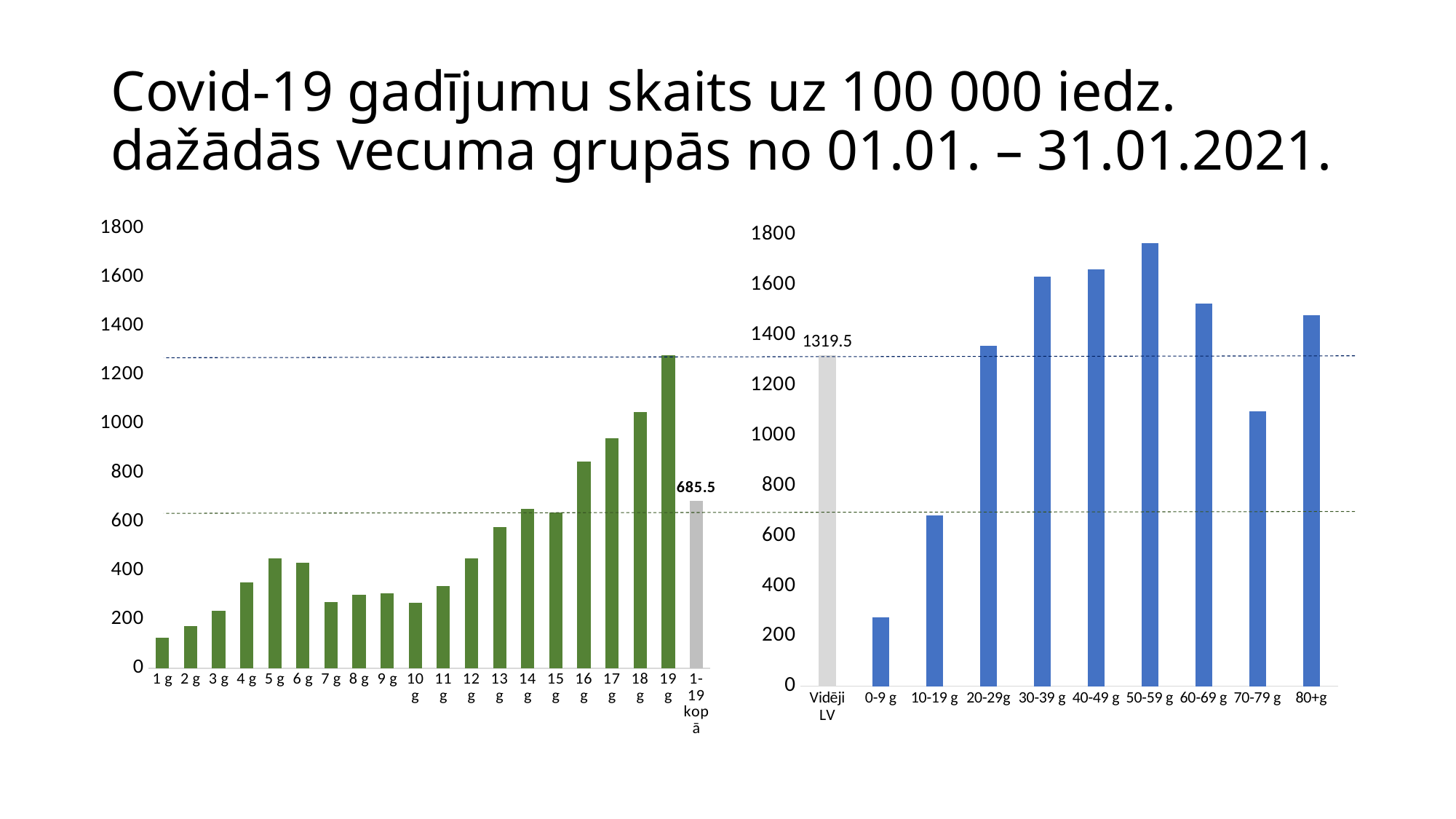
What is the difference between the 'Vidēji LV' value on the right chart and the '1-19 kopā' value on the left chart? 634 On the left chart, which age has the lowest value? 1 g On the right chart, which is larger, the value for 40-49 g or for 60-69 g? 40-49 g On the left chart, what is the value for the '1-19 kopā' bar? 685.5 On the left chart, is the value for 19 g greater or less than 1200? greater On the left chart, do the values rise or fall from 10 g to 19 g? rise On the right chart, what is the value for 'Vidēji LV'? 1319.5 On the right chart, which age group has the highest value? 50-59 g On the right chart, is the value for 70-79 g greater or less than 1000? greater On the left chart, which single age (1 g to 19 g) has the highest value? 19 g How many bars does the right chart show? 10 On the right chart, which age group has the lowest value? 0-9 g